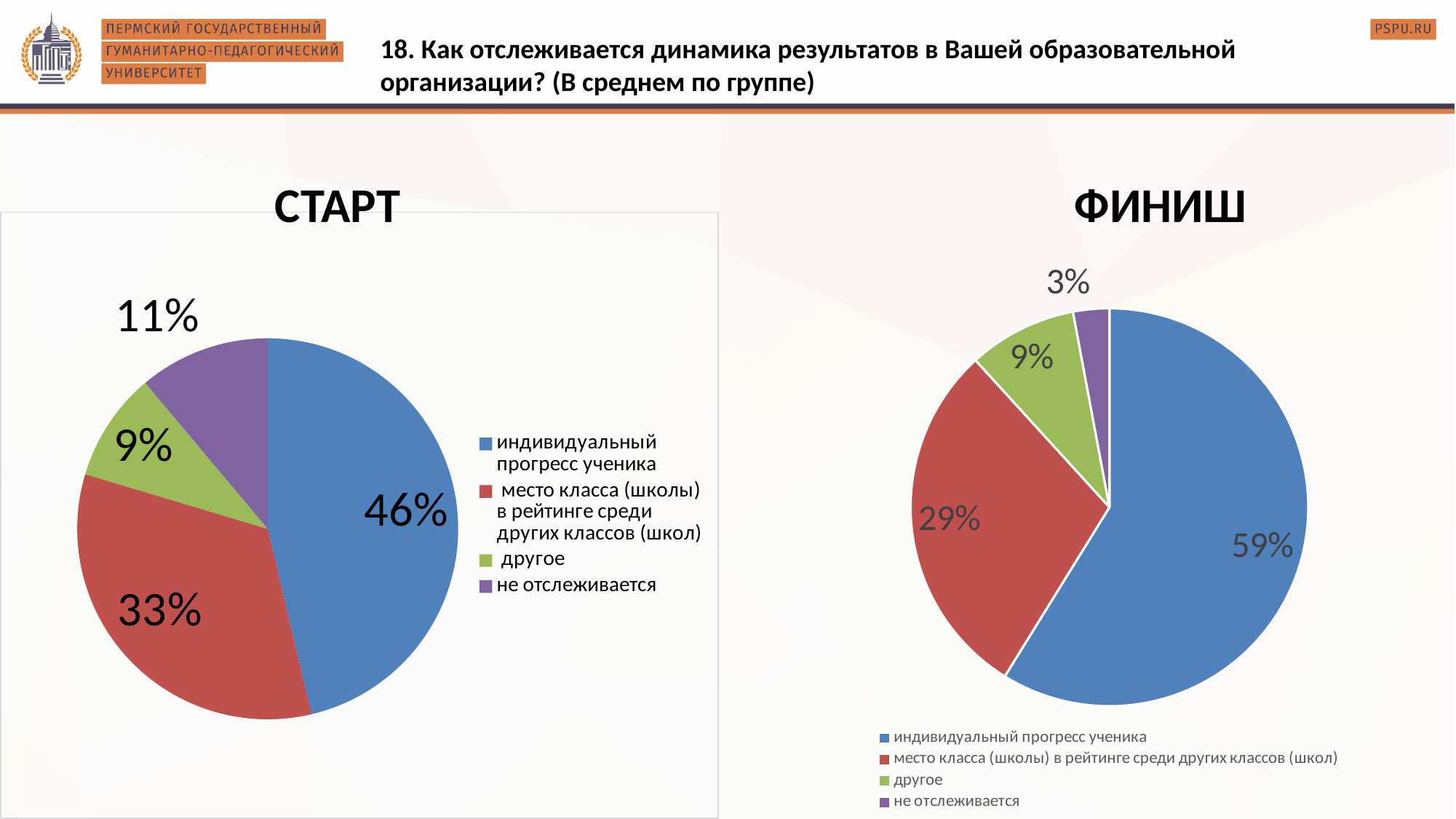
In the ФИНИШ pie chart, what colour is the slice for 'другое'? green In the СТАРТ pie chart, which is larger: the slice for 'место класса (школы) в рейтинге среди других классов (школ)' or the slice for 'не отслеживается'? место класса (школы) в рейтинге среди других классов (школ) In the СТАРТ pie chart, what share is shown for 'индивидуальный прогресс ученика'? 46% How many slices does the ФИНИШ pie chart have? 4 In the ФИНИШ pie chart, what share is shown for 'не отслеживается'? 3% In the ФИНИШ pie chart, which category has the largest slice? индивидуальный прогресс ученика How many entries does the legend of the СТАРТ chart list? 4 What type of chart is the СТАРТ chart? pie chart In the СТАРТ pie chart, what share is shown for 'не отслеживается'? 11% In the ФИНИШ pie chart, what share is shown for 'место класса (школы) в рейтинге среди других классов (школ)'? 29% What is the difference between the share for 'индивидуальный прогресс ученика' in the ФИНИШ chart and in the СТАРТ chart? 13% In the СТАРТ pie chart, which category has the smallest slice? другое